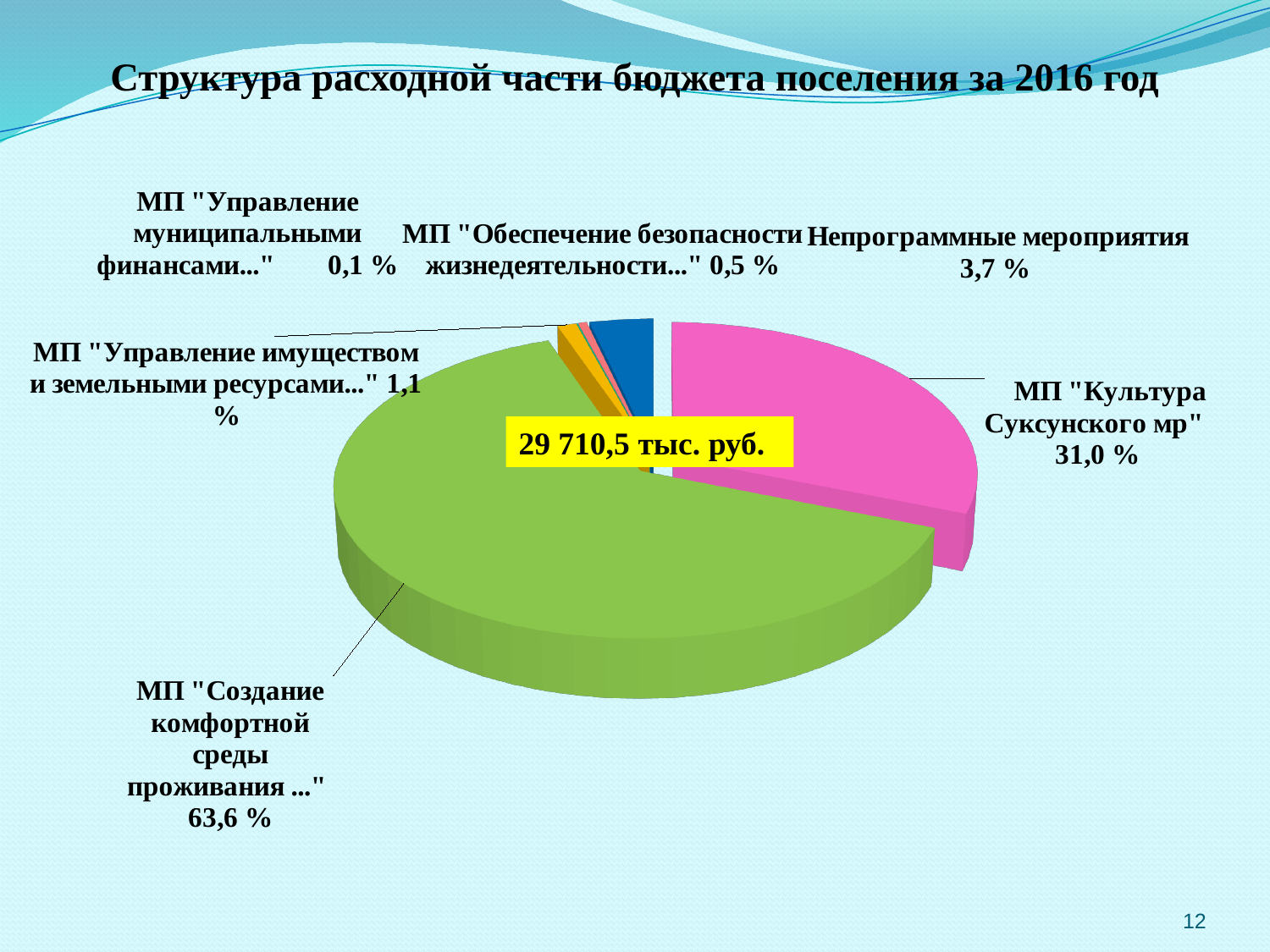
What share of the pie does МП "Управление имуществом и земельными ресурсами..." have? 1,1 % What share of the pie do Непрограммные мероприятия have? 3,7 % Which category has the smallest share of the pie? МП "Управление муниципальными финансами..." What share of the pie does МП "Обеспечение безопасности жизнедеятельности..." have? 0,5 % What share of the pie does МП "Культура Суксунского мр" have? 31,0 % What kind of chart is shown on the slide? Pie chart How many slices does the pie chart have? 6 What is the title of the chart on the slide? Структура расходной части бюджета поселения за 2016 год What share of the pie does МП "Управление муниципальными финансами..." have? 0,1 % What share of the pie does МП "Создание комфортной среды проживания ..." have? 63,6 % Which category has the largest share of the pie? МП "Создание комфортной среды проживания ..." What total amount is shown in the label in the centre of the pie chart? 29 710,5 тыс. руб.